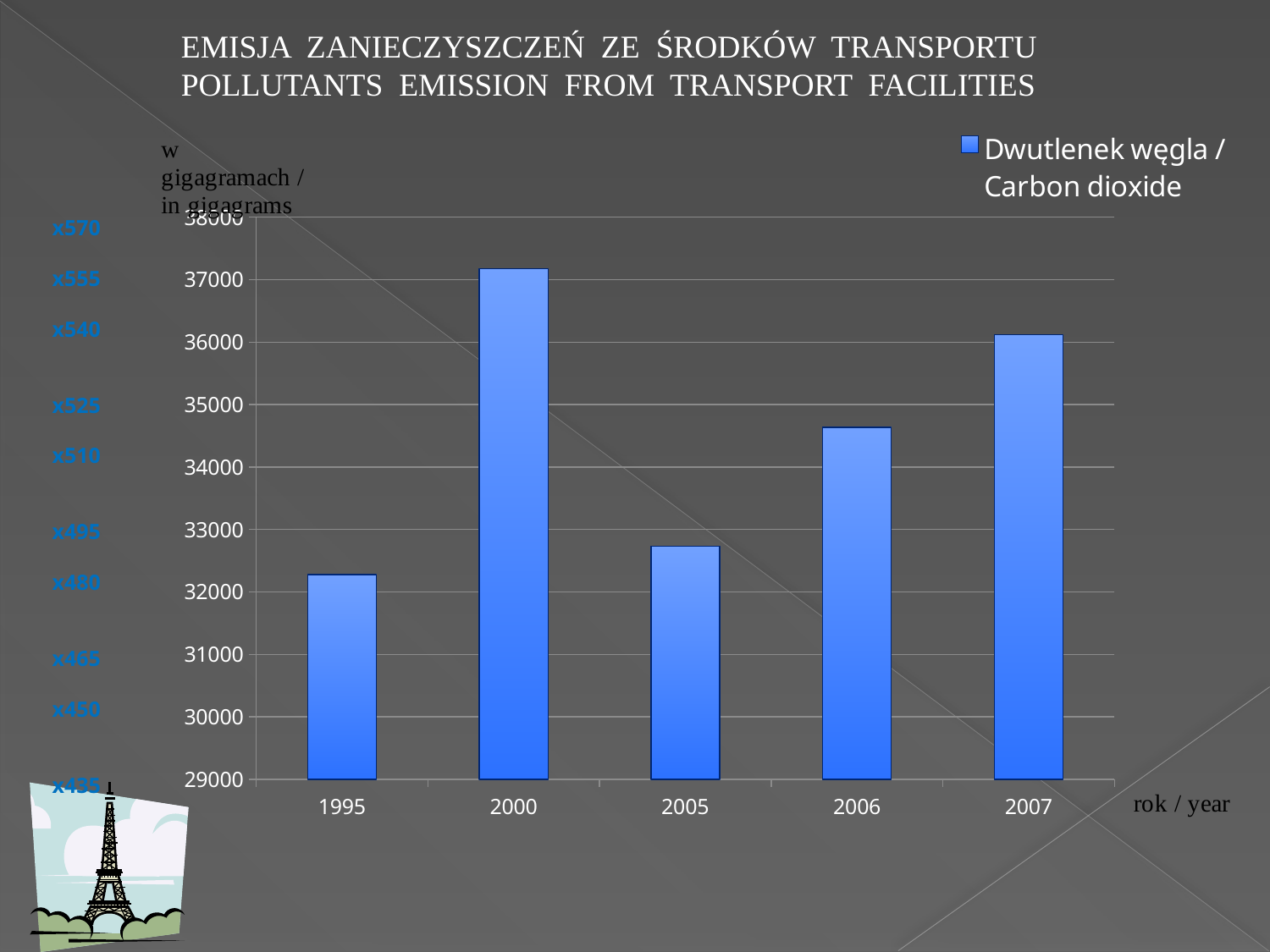
Is the carbon dioxide emission for 2007 greater or less than 35000? greater Is the carbon dioxide emission for 2006 greater or less than 34000? greater Is the carbon dioxide emission for 2000 greater or less than 36000? greater Which year has the lowest carbon dioxide emission in the chart? 1995 What series name is shown in the chart's legend? Dwutlenek węgla / Carbon dioxide How many years are shown on the x axis of the chart? 5 How many series does the chart's legend list? 1 Which year has a larger carbon dioxide emission, 2006 or 2007? 2007 Do the carbon dioxide emission values rise or fall from 2005 to 2007? rise What kind of chart is shown on the slide? bar chart Which year has the highest carbon dioxide emission in the chart? 2000